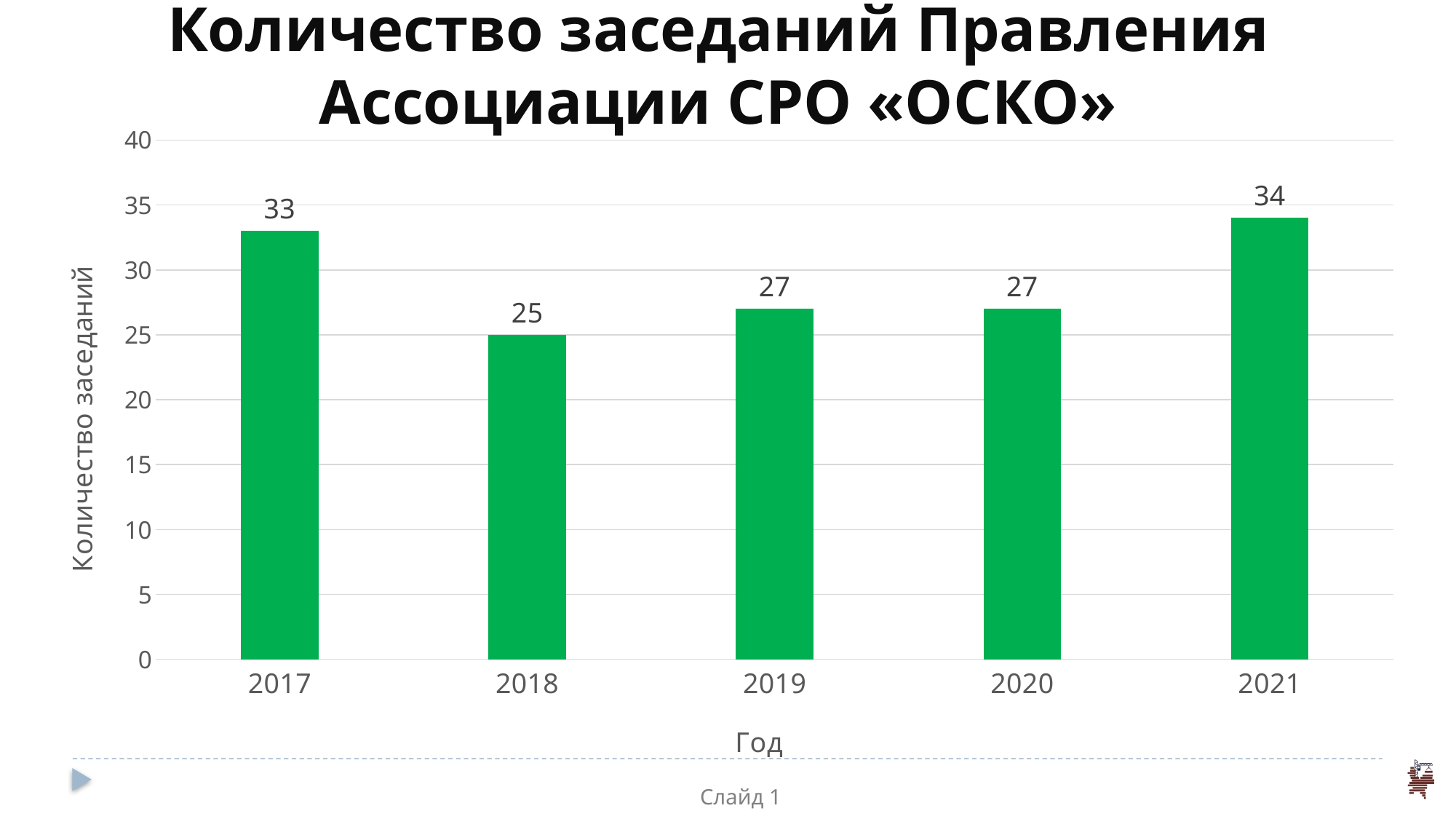
How many years are shown on the x axis? 5 What kind of chart is shown on the slide? bar chart What is the difference between the values for 2017 and 2019? 6 Is the value for 2019 greater or less than 30? less Which is larger, the value for 2017 or the value for 2020? 2017 How many board meetings were held in 2017? 33 What is the value shown for 2021? 34 What is the value shown for 2018? 25 Which year has the lowest number of meetings? 2018 What is the label of the x axis? Год Which year has the highest number of meetings? 2021 What is the difference between the values for 2021 and 2018? 9